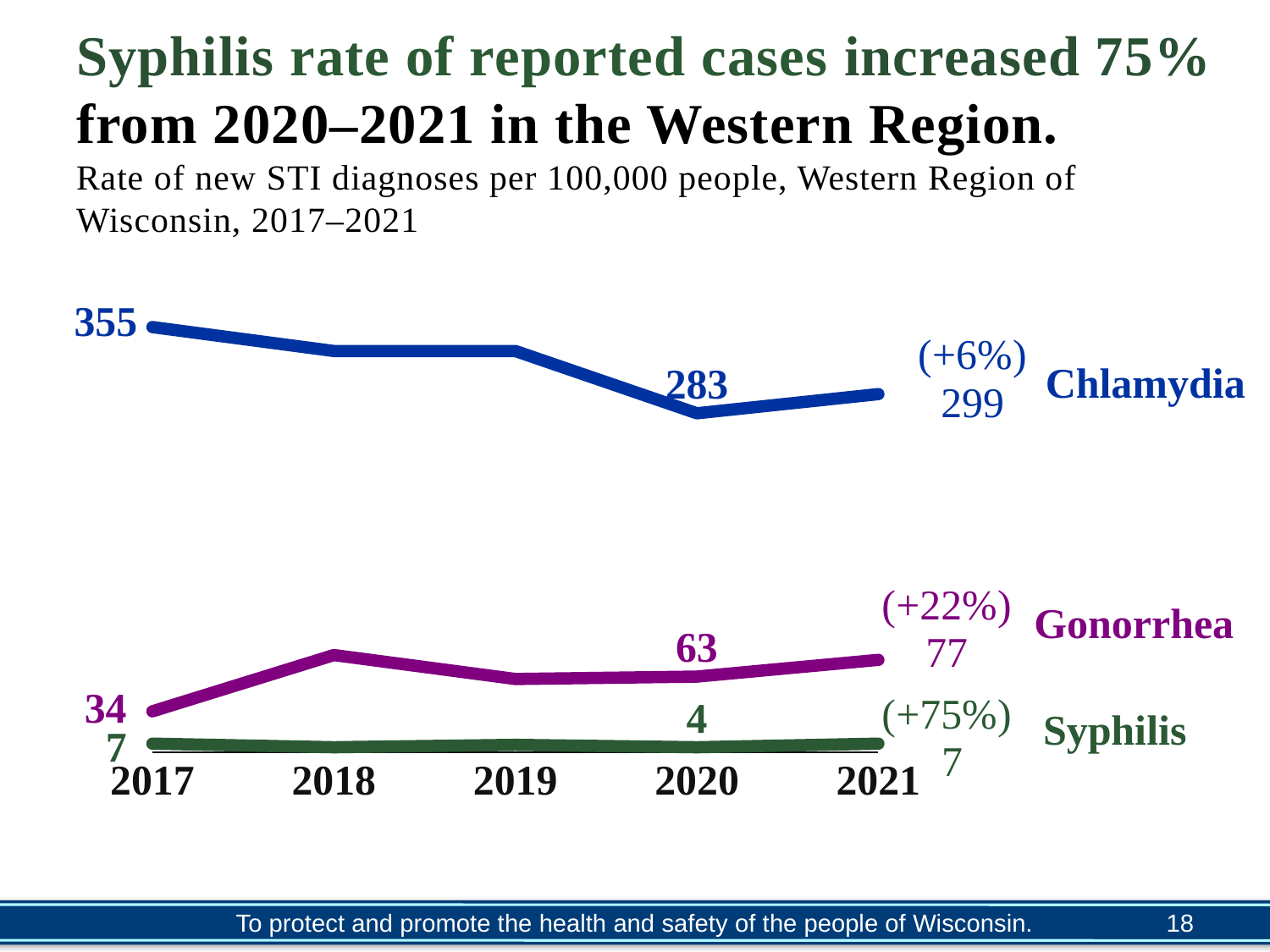
Which STI had the highest rate in 2021? Chlamydia What was the chlamydia rate in 2021? 299 How many years are shown on the x axis? 5 By how much did the chlamydia rate change from 2020 to 2021? 16 Was the gonorrhea rate higher in 2018 or in 2017? 2018 What was the syphilis rate in 2021? 7 How many STIs (series) are plotted on the chart? 3 What is the difference between the gonorrhea rate in 2021 and in 2017? 43 Which STI had the lowest rate in 2017? Syphilis What was the chlamydia rate in 2017? 355 What type of chart is shown on the slide? Line chart What was the gonorrhea rate in 2020? 63